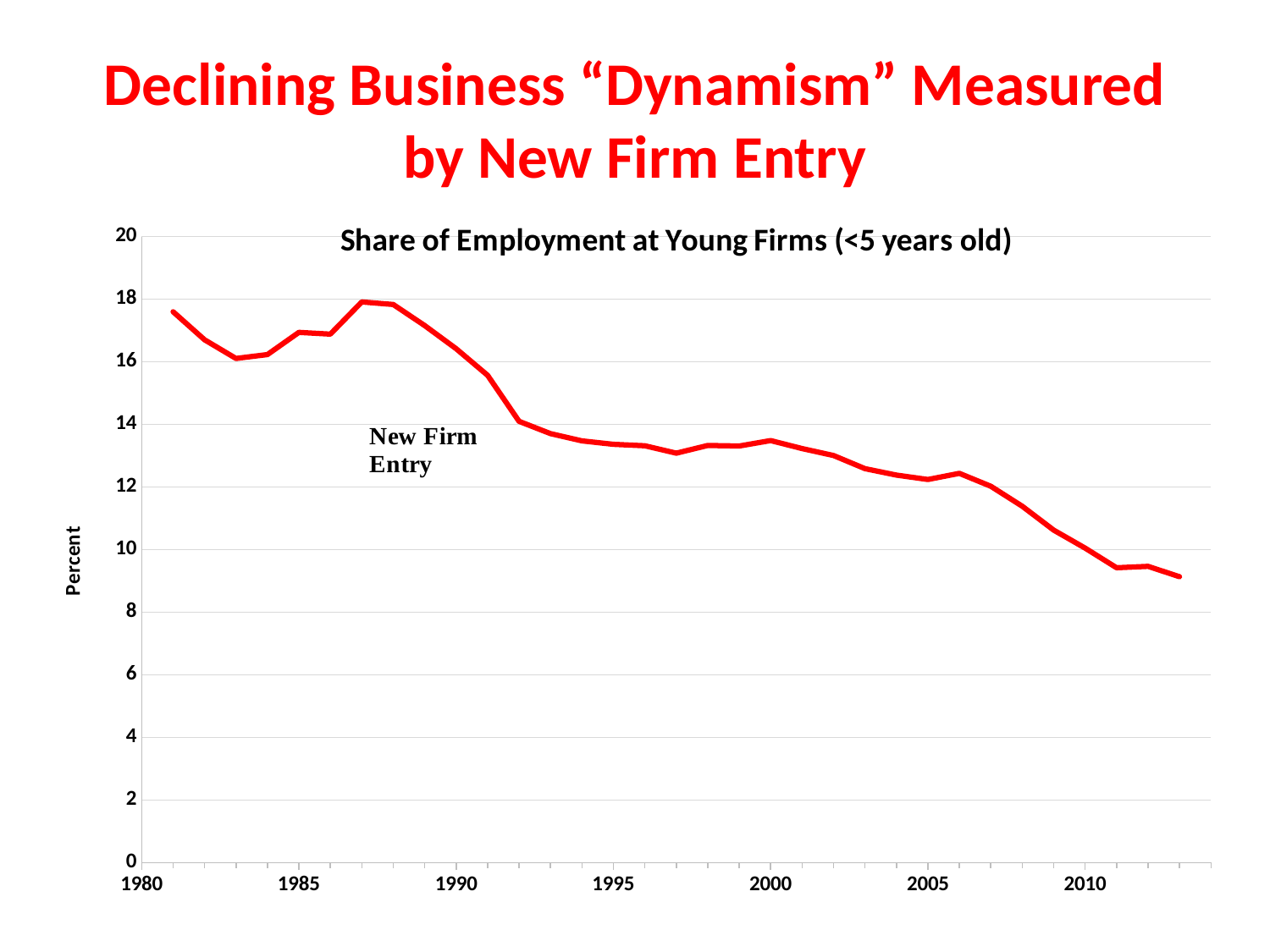
Which year has the larger value, 1990 or 2000? 1990 Is the value for 1995 greater or less than 14? less Is the value for 2005 greater or less than 14? less What kind of chart is shown on the slide? line chart Is the value for 2011 greater or less than 10? less What is the title of the chart? Share of Employment at Young Firms (<5 years old) What is the label on the vertical axis? Percent Which year has the larger value, 1981 or 2013? 1981 Overall, do the values rise or fall from 1980 to 2013? fall